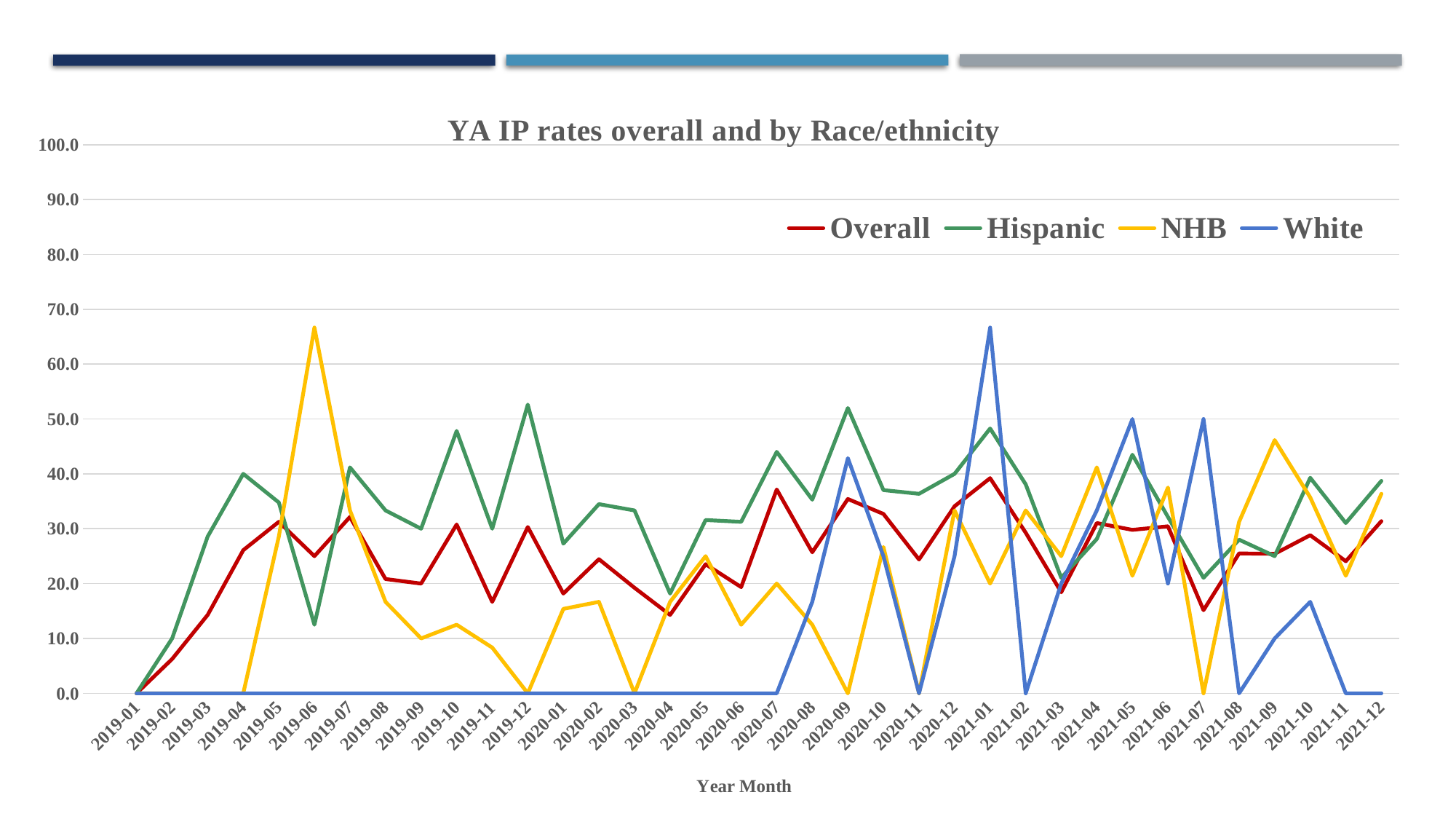
What is the title of the chart? YA IP rates overall and by Race/ethnicity In 2019-12, which is larger, the Hispanic value or the NHB value? Hispanic What is the value for White in 2019-10? 0.0 How many months are shown along the x axis? 36 What is the value for NHB in 2021-07? 0.0 What kind of chart is shown on the slide? line chart Is the value for Overall in 2019-11 greater or less than 20.0? less Which series has the lowest value in 2019-06? White Which series has the highest value in 2021-01? White What is the label of the x axis? Year Month Is the value for NHB in 2019-06 greater or less than 60.0? greater How many series does the legend list? 4